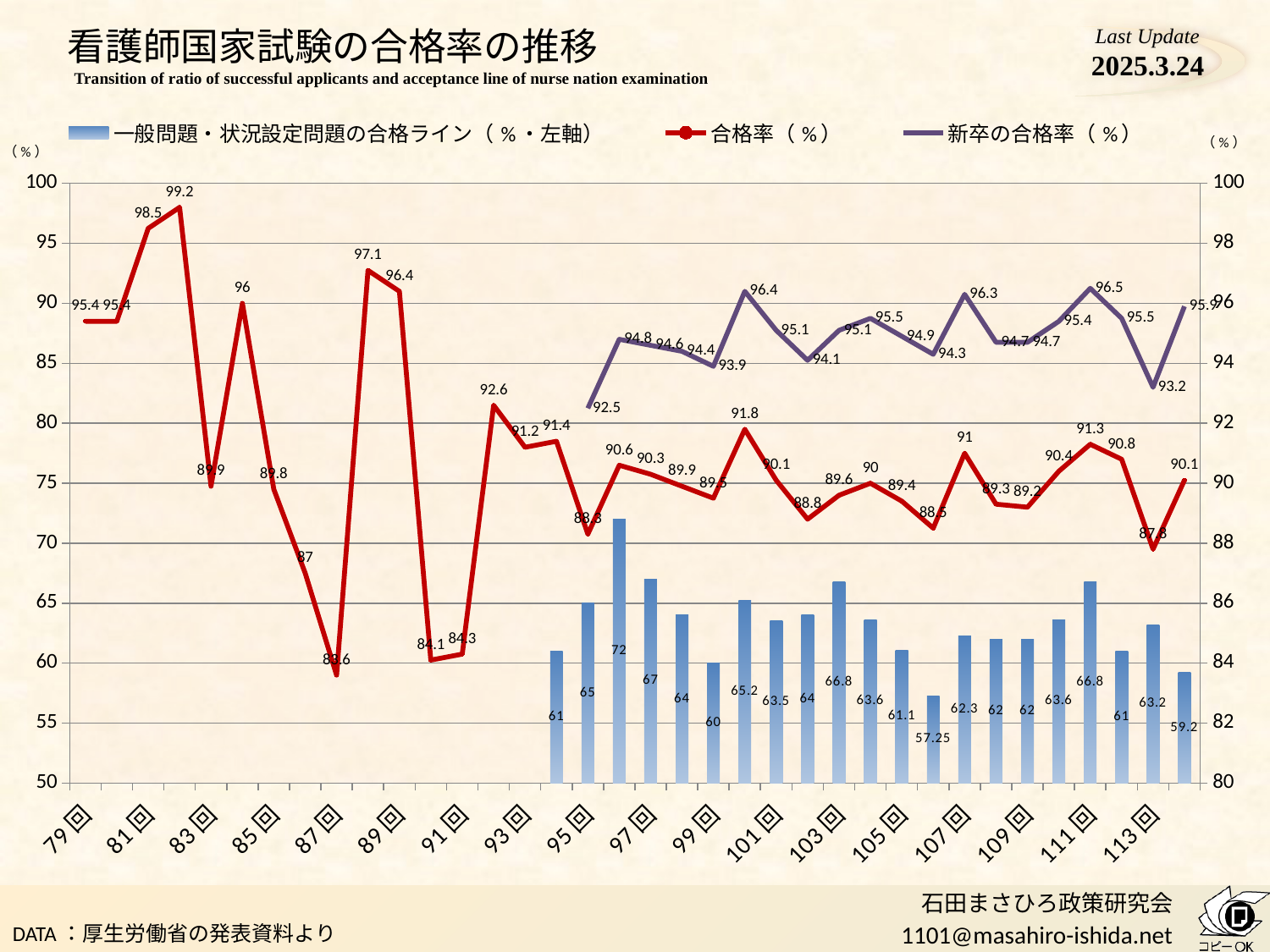
What kind of chart is shown on the slide? Combined bar and line chart What is the 新卒の合格率（%） value at 113回? 93.2 What is the difference between the highest and lowest values of the 合格率（%） line? 15.6 What is the highest value of the 合格率（%） line? 99.2 How many series does the legend list? 3 What is the lowest bar value for 一般問題・状況設定問題の合格ライン? 57.25 What is the 合格率（%） value at 113回? 87.8 What is the lowest value of the 合格率（%） line? 83.6 What is the highest value of the 新卒の合格率（%） line? 96.5 What is the highest bar value for 一般問題・状況設定問題の合格ライン? 72 What is the 合格率（%） value at 81回? 98.5 What is the 合格率（%） value at 79回? 95.4